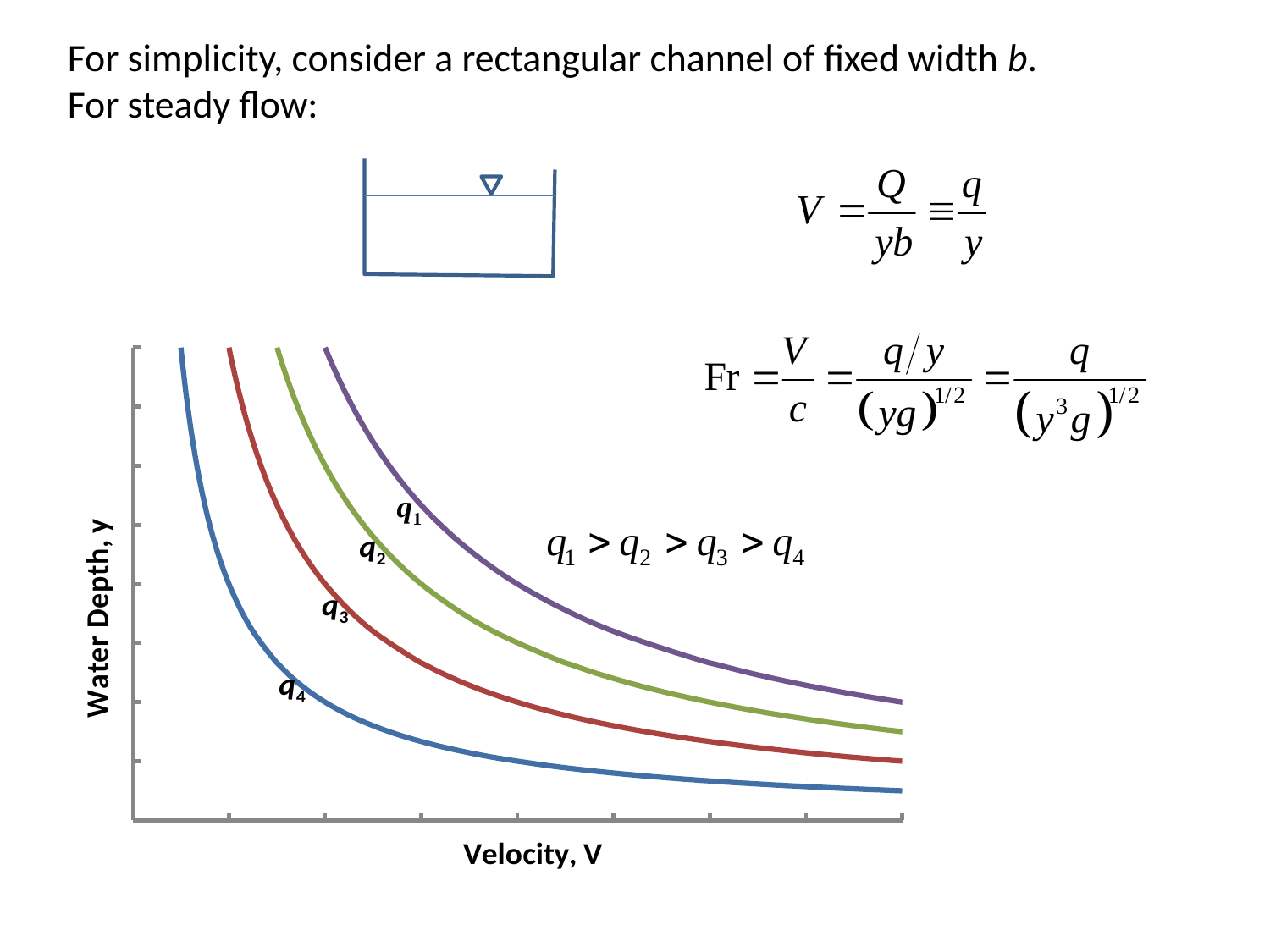
Which curve is drawn in purple? q1 Which curve lies lowest on the chart (smallest water depth at any given velocity)? q4 What kind of chart is shown on the slide? line chart At the same velocity, which curve shows a larger water depth, q4 or q1? q1 What is the label of the horizontal axis of the chart? Velocity, V As velocity increases along the x axis, does water depth on each curve rise or fall? fall How many curves are plotted on the chart? 4 Which curve lies highest on the chart (greatest water depth at any given velocity)? q1 Which curve is drawn in blue? q4 At the same velocity, which curve shows a larger water depth, q2 or q3? q2